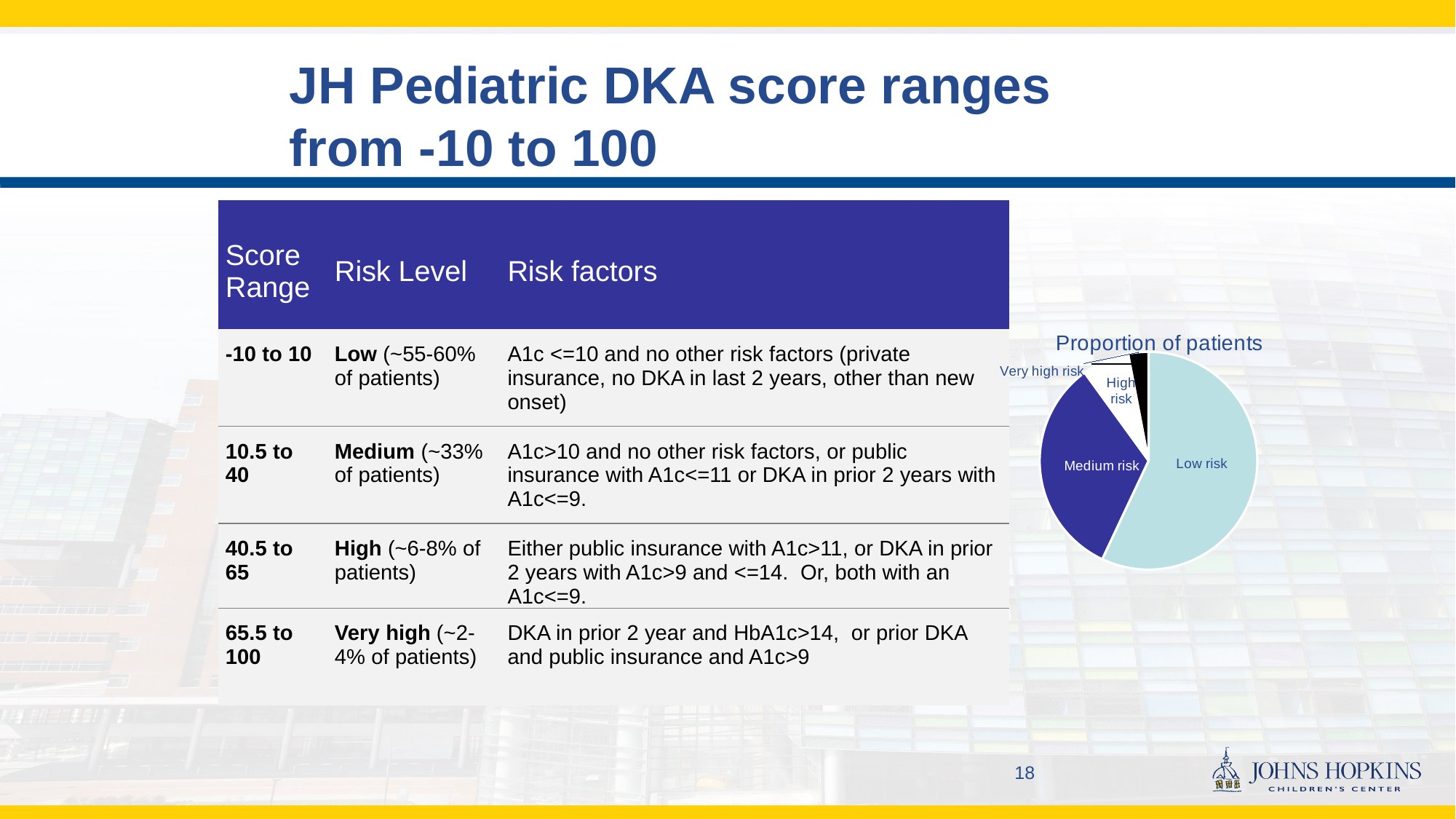
In the pie chart, which is larger: High risk or Very high risk? High risk What kind of chart is shown on the slide? Pie chart How many slices does the pie chart have? 4 Which slice of the pie chart is the second largest? Medium risk In the pie chart, which is larger: Low risk or Medium risk? Low risk What is the title of the pie chart? Proportion of patients Which slice of the pie chart is the smallest? Very high risk What colour is the Medium risk slice in the pie chart? Dark blue Which slice of the pie chart is the largest? Low risk